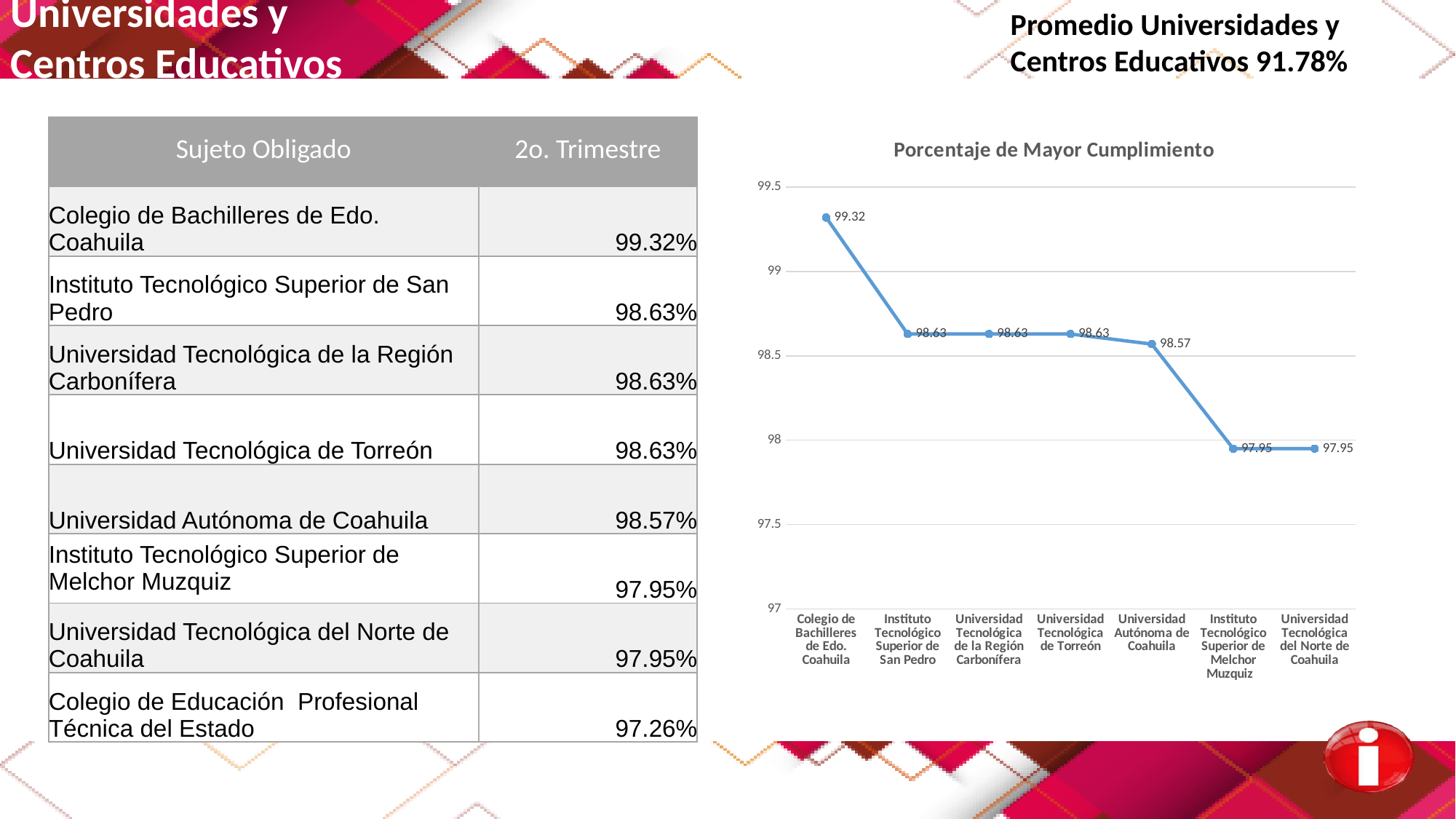
Which is larger in the chart: the value for Universidad Tecnológica de Torreón or the value for Universidad Autónoma de Coahuila? Universidad Tecnológica de Torreón What is the title of the chart? Porcentaje de Mayor Cumplimiento What type of chart is shown on the slide? line chart How many data points are plotted in the chart? 7 What is the difference between the values for Colegio de Bachilleres de Edo. Coahuila and Universidad Autónoma de Coahuila in the chart? 0.75 What is the value plotted for Colegio de Bachilleres de Edo. Coahuila in the chart? 99.32 What is the value plotted for Universidad Tecnológica del Norte de Coahuila in the chart? 97.95 What is the difference between the values for Instituto Tecnológico Superior de San Pedro and Instituto Tecnológico Superior de Melchor Muzquiz in the chart? 0.68 What is the value plotted for Universidad Autónoma de Coahuila in the chart? 98.57 Is the value for Instituto Tecnológico Superior de Melchor Muzquiz greater or less than 98? less Do the values in the chart generally rise or fall from left to right along the x axis? fall Which category has the highest value in the chart? Colegio de Bachilleres de Edo. Coahuila